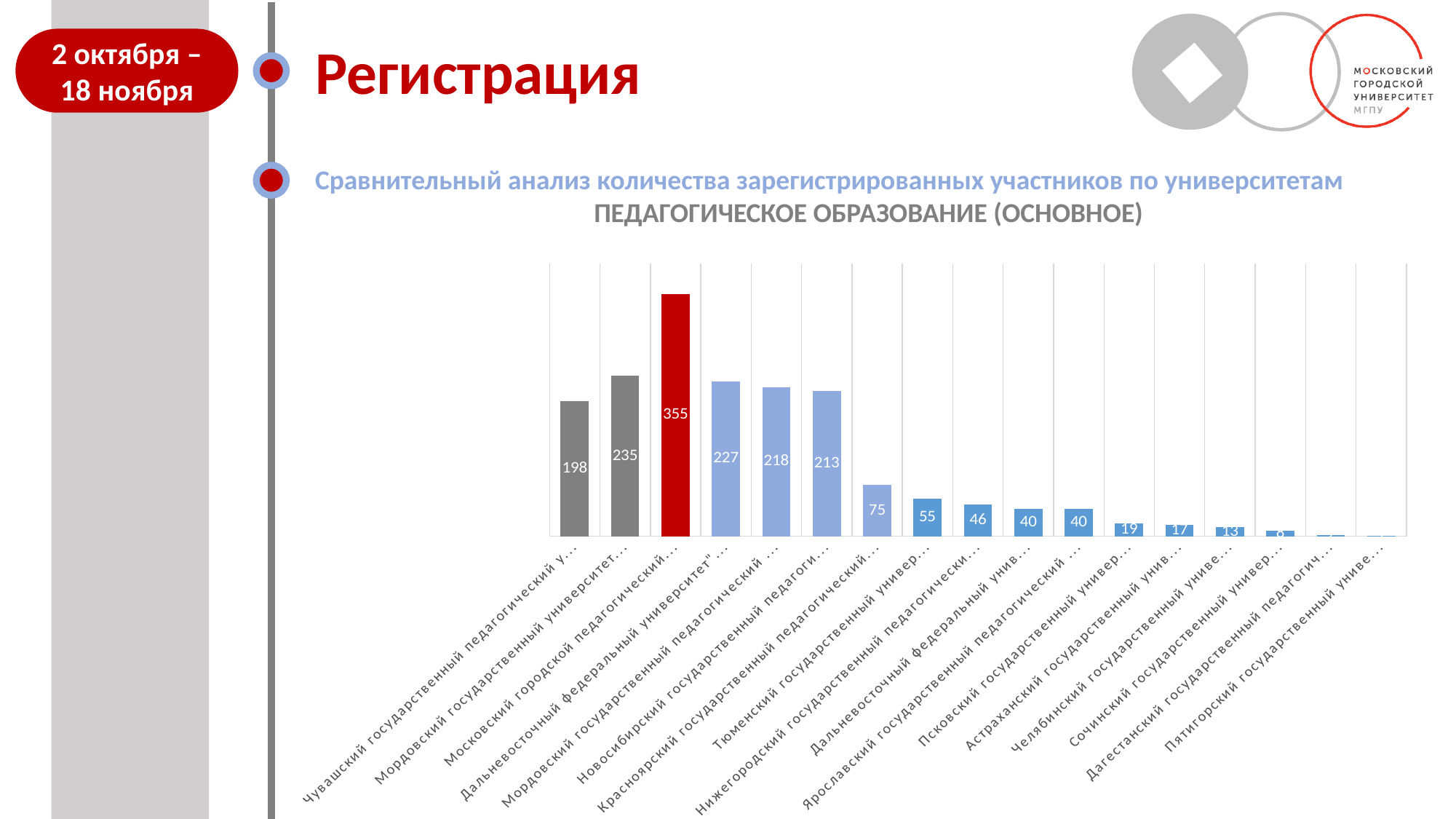
What type of chart is shown on the slide? bar chart What is the value for Чувашский государственный педагогический университет? 198 What colour is the bar for Московский городской педагогический университет? red How many universities are shown on the x axis of the chart? 17 What is the value for Московский городской педагогический университет? 355 What is the value for Псковский государственный университет? 19 What is the value for Новосибирский государственный педагогический университет? 213 Which university has the highest number of registered participants? Московский городской педагогический университет What is the difference between the values for Тюменский государственный университет and Нижегородский государственный педагогический университет? 9 Which is larger: the value for Мордовский государственный университет or the value for Мордовский государственный педагогический университет? Мордовский государственный университет What is the difference between the values for Московский городской педагогический университет and Мордовский государственный университет? 120 What is the value for Красноярский государственный педагогический университет? 75